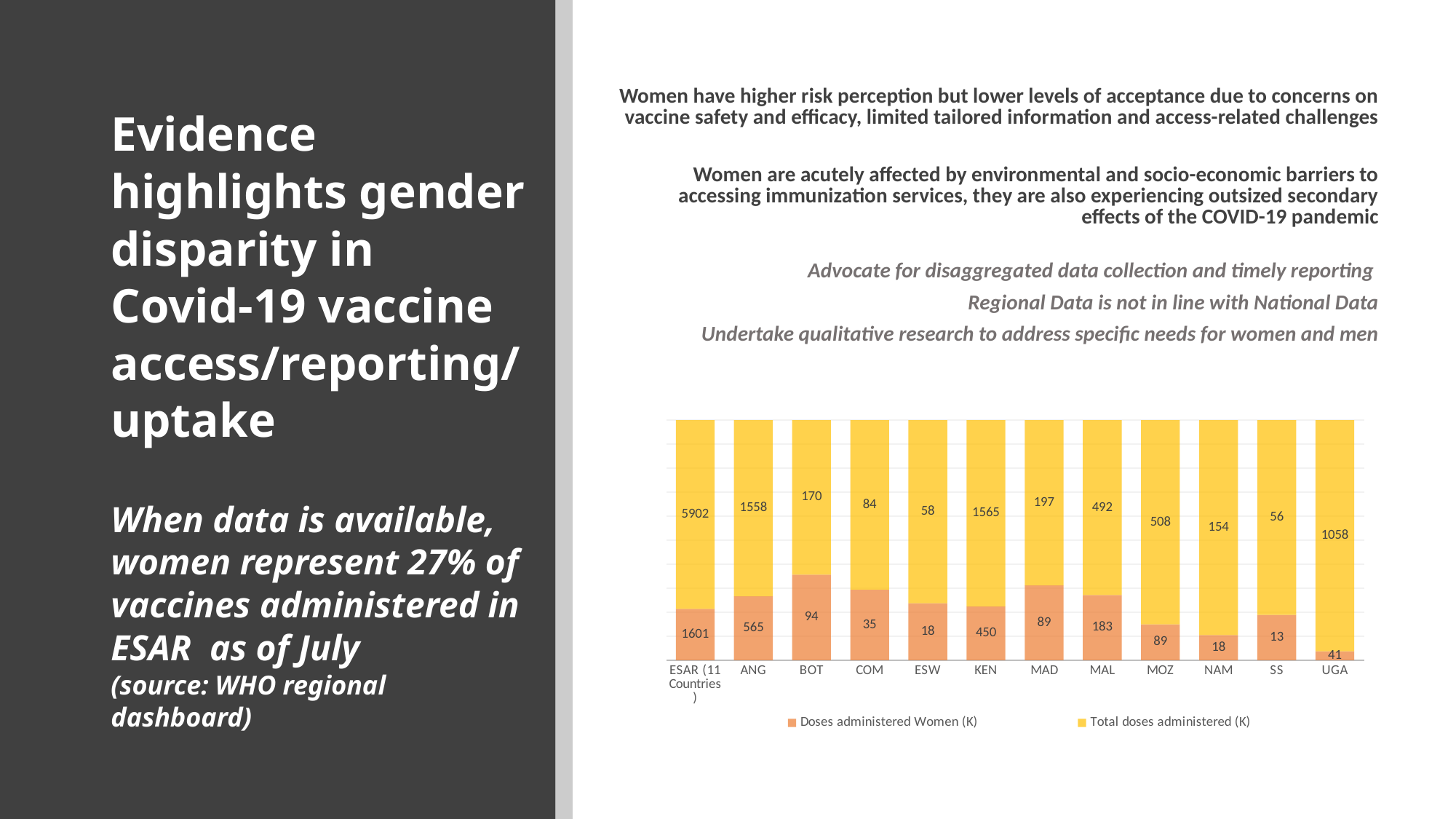
Which colour represents Total doses administered (K) in the chart? Yellow Which category has the highest value for Total doses administered (K)? ESAR (11 Countries) What kind of chart is shown on the slide? Stacked bar chart What is the value of Doses administered Women (K) for KEN? 450 Which category has the lowest value for Doses administered Women (K)? SS How many series does the chart legend list? 2 Which is larger: Doses administered Women (K) for ANG or for BOT? ANG What is the value of Total doses administered (K) for UGA? 1058 What is the difference between Total doses administered (K) and Doses administered Women (K) for KEN? 1115 What is the value of Total doses administered (K) for MOZ? 508 What is the value of Doses administered Women (K) for MAL? 183 How many categories are shown on the x axis of the chart? 12